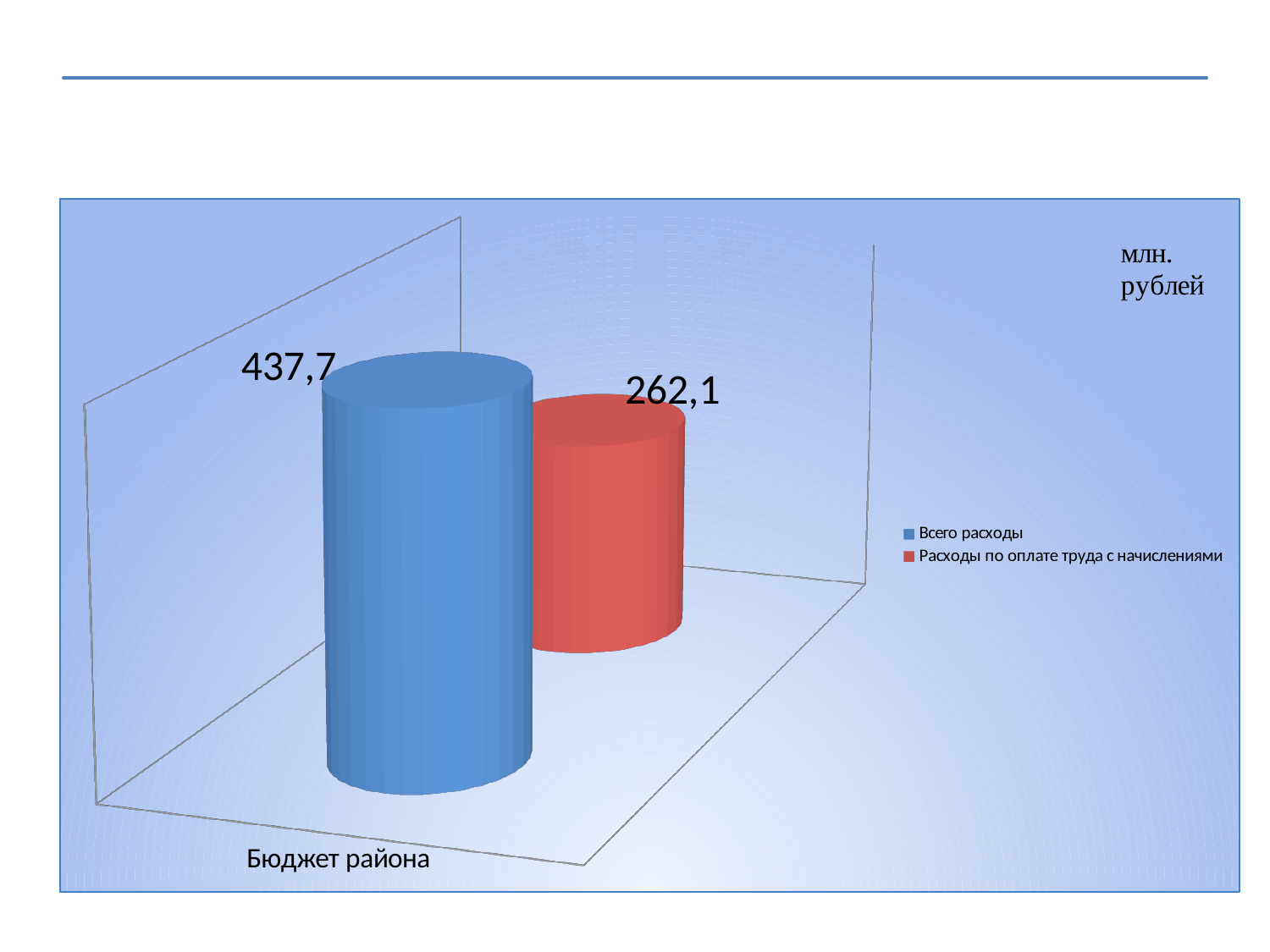
What is the value for "Расходы по оплате труда с начислениями"? 262,1 How many categories are shown on the x axis? 1 What kind of chart is shown on the slide? Bar chart What unit is indicated in the top right corner of the chart? млн. рублей Which series has the higher value, "Всего расходы" or "Расходы по оплате труда с начислениями"? Всего расходы Which series has the highest value on the chart? Всего расходы How many series does the legend list? 2 Which series has the lowest value on the chart? Расходы по оплате труда с начислениями What is the value for "Всего расходы"? 437,7 What is the name of the category shown on the x axis? Бюджет района What is the difference between "Всего расходы" and "Расходы по оплате труда с начислениями"? 175,6